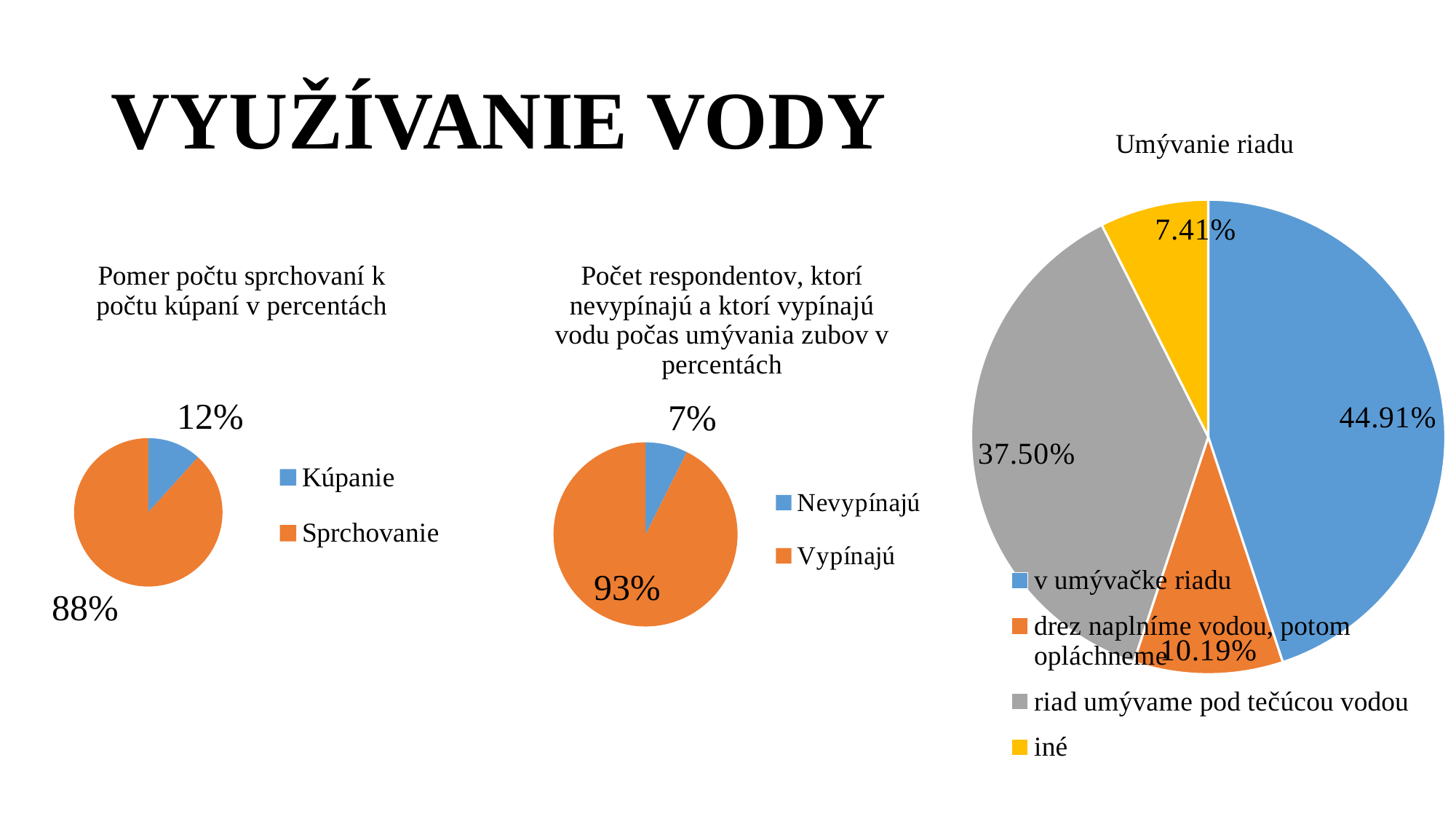
In the left chart (Pomer počtu sprchovaní k počtu kúpaní v percentách), what is the value for Kúpanie? 12% In the middle chart about turning off water while brushing teeth, how many categories does the legend list? 2 In the left chart (Pomer počtu sprchovaní k počtu kúpaní v percentách), what is the difference between Sprchovanie and Kúpanie? 76% In the Umývanie riadu chart, how many slices does the pie have? 4 In the middle chart about turning off water while brushing teeth, which category is the largest? Vypínajú What type of chart is the Umývanie riadu chart? Pie chart In the Umývanie riadu chart, which category is the smallest? iné In the left chart (Pomer počtu sprchovaní k počtu kúpaní v percentách), what is the value for Sprchovanie? 88% In the middle chart about turning off water while brushing teeth, what is the value for Nevypínajú? 7% In the Umývanie riadu chart, which is larger: drez naplníme vodou, potom opláchneme or iné? drez naplníme vodou, potom opláchneme In the Umývanie riadu chart, what is the value for riad umývame pod tečúcou vodou? 37.50% In the Umývanie riadu chart, what is the value for v umývačke riadu? 44.91%